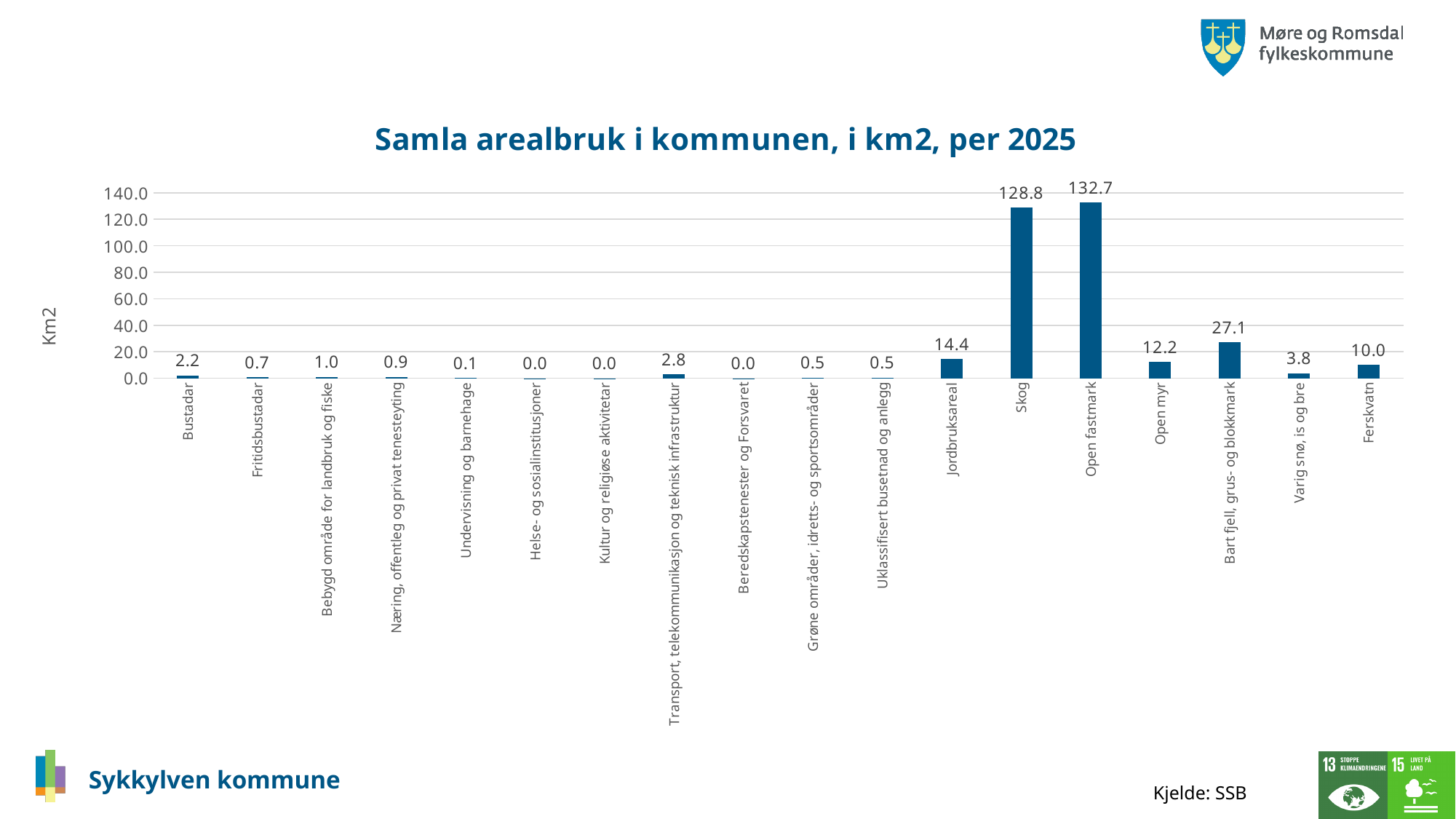
What is the value for Ferskvatn? 10.0 Is the value for Skog greater or less than 120? greater Which category has the highest value? Open fastmark How many categories are shown on the x axis? 18 Which is larger, the value for Open myr or the value for Ferskvatn? Open myr What is the value for Jordbruksareal? 14.4 What is the difference between the values for Bart fjell, grus- og blokkmark and Jordbruksareal? 12.7 What is the title of the chart? Samla arealbruk i kommunen, i km2, per 2025 What type of chart is shown on the slide? Bar chart What is the difference between the values for Open fastmark and Skog? 3.9 What is the value for Bustadar? 2.2 What is the value for Skog? 128.8